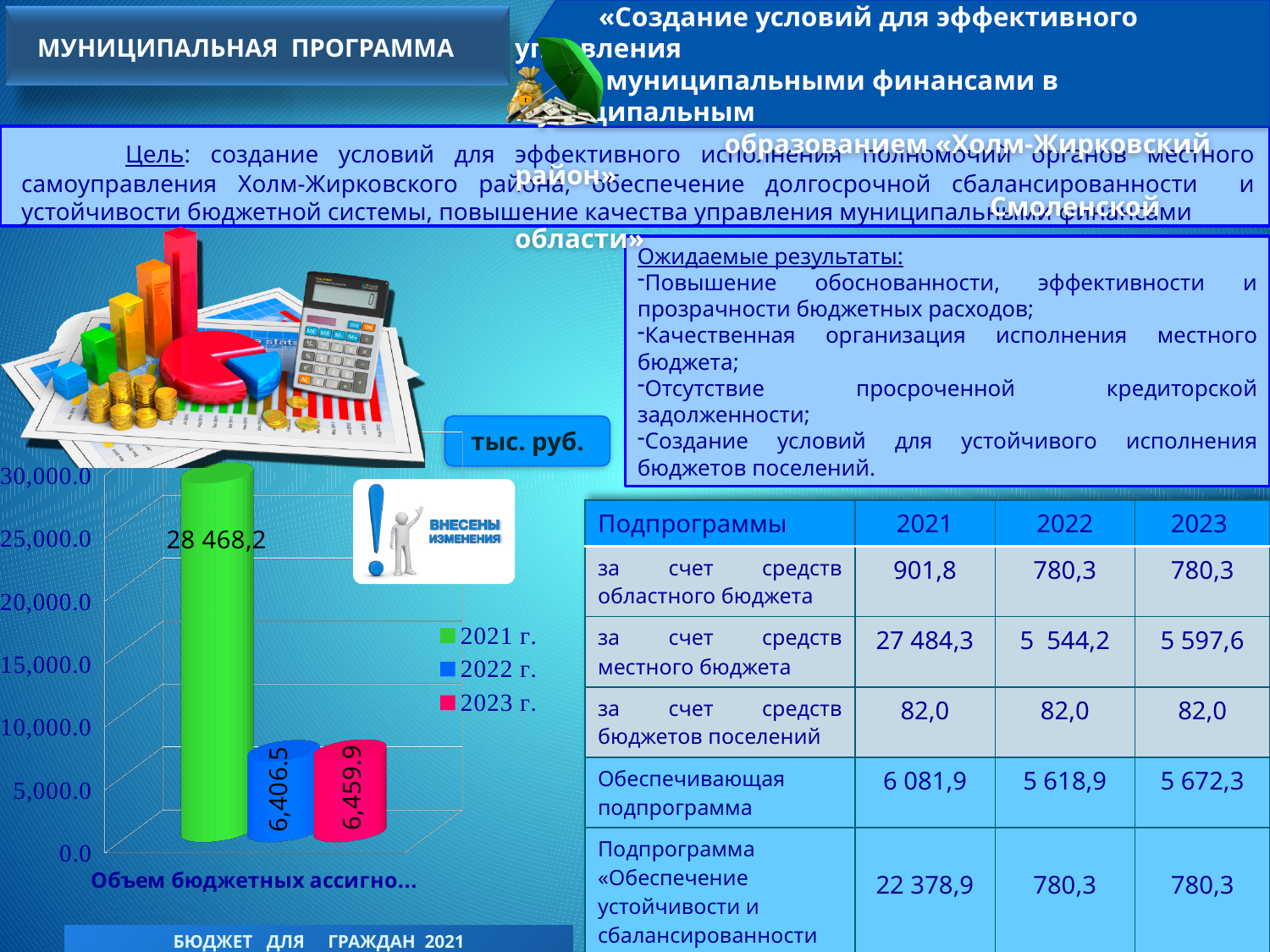
Which year has the highest bar in the chart? 2021 г. What is the value of the green 2021 г. bar in the chart? 28 468,2 What is the difference between the 2023 г. bar and the 2022 г. bar? 53.4 What value is labelled on the pink 2023 г. bar? 6,459.9 What value is labelled on the blue 2022 г. bar? 6,406.5 What unit is shown in the box above the chart? тыс. руб. How many series does the chart legend list? 3 How many bars are plotted in the chart? 3 Which is larger in the chart, the 2022 г. bar or the 2023 г. bar? 2023 г. What kind of chart is shown on the slide? bar chart Which year has the lowest bar in the chart? 2022 г. Is the value for 2021 г. greater or less than 25,000.0? greater